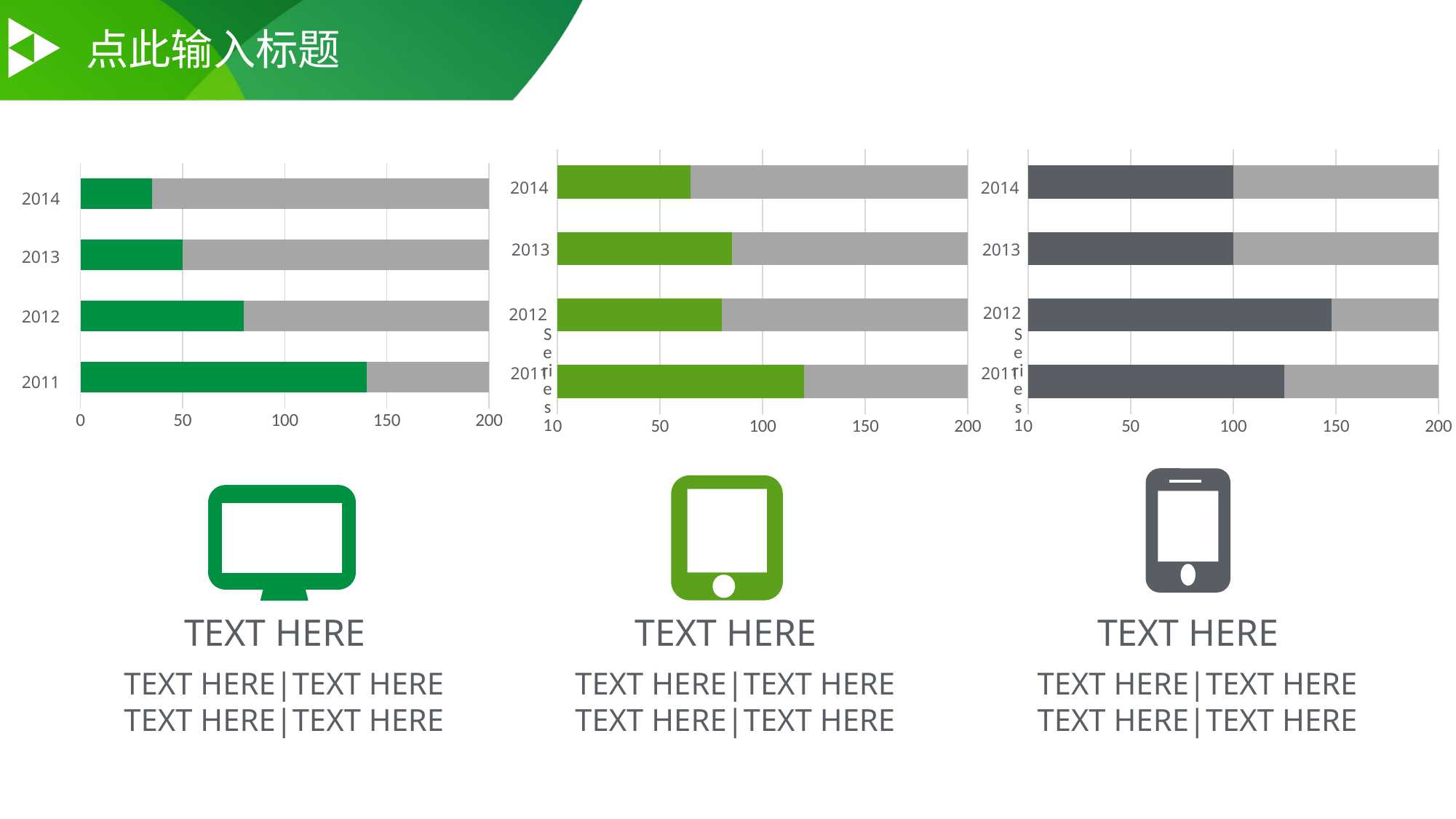
In the left chart, which year has the longest green bar? 2011 In the left chart, is the green bar for 2011 greater or less than 100? greater In the left chart, which year has the shortest green bar? 2014 In the left chart, is the green bar for 2014 greater or less than 50? less In the left chart, do the green bar values rise or fall from 2011 to 2014? fall In the middle chart, which year has the shortest green bar? 2014 In the middle chart, is the green bar for 2011 greater or less than 100? greater How many categories does the left chart show? 4 In the right chart, which year has the longest dark grey bar? 2012 What type of chart is the left chart? bar chart In the middle chart, which year has the longest green bar? 2011